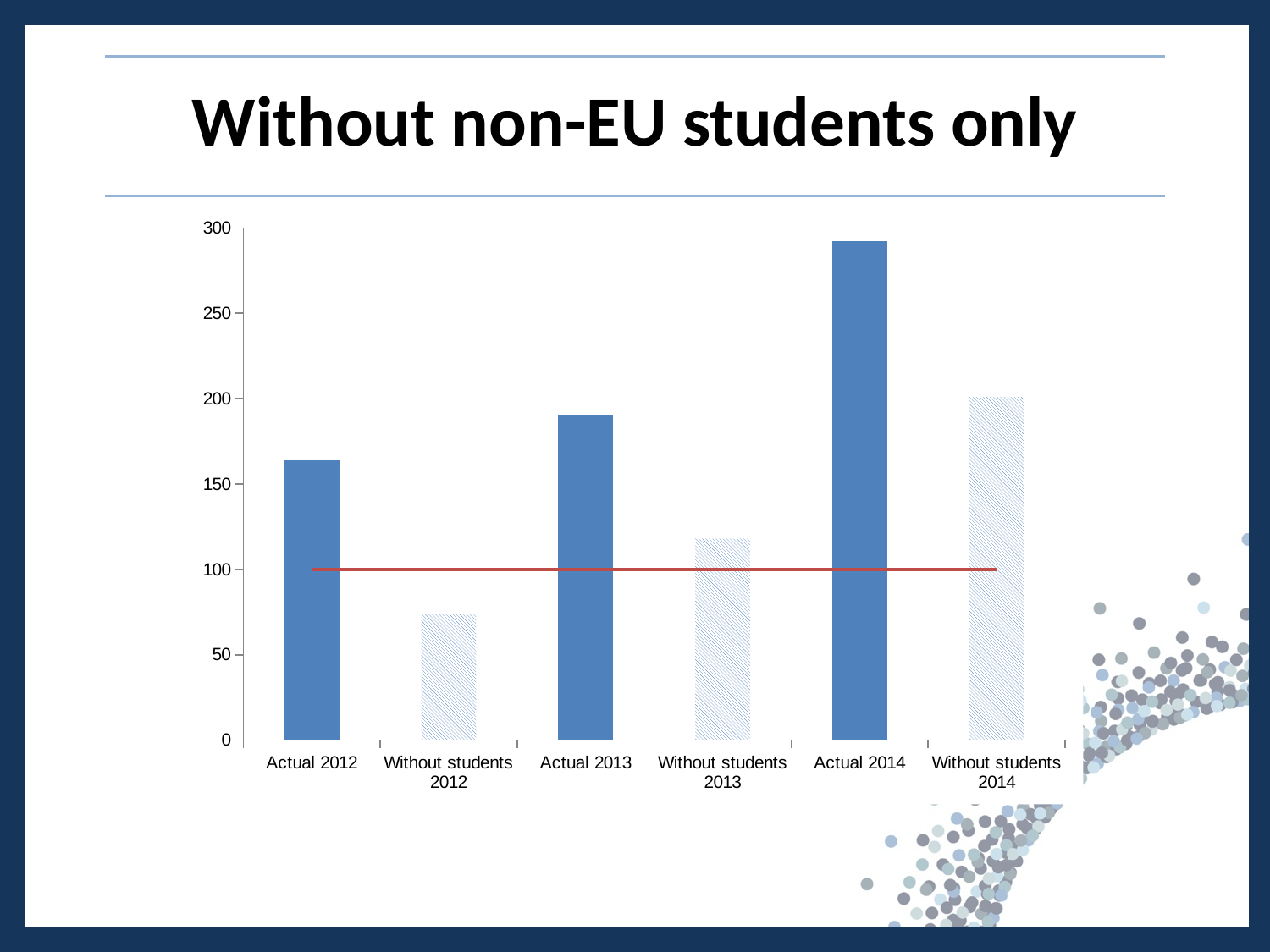
How many categories are shown on the x axis of the chart? 6 Is the value for Without students 2013 greater or less than 100? greater What kind of chart is shown on the slide? bar chart Which category has the lowest bar in the chart? Without students 2012 Which is larger, the bar for Actual 2013 or the bar for Without students 2013? Actual 2013 Is the value for Actual 2014 greater or less than 250? greater Which category has the highest bar in the chart? Actual 2014 Is the value for Actual 2012 greater or less than 150? greater At what value on the y axis is the red horizontal line drawn? 100 Do the 'Actual' bars rise or fall from 2012 to 2014? rise